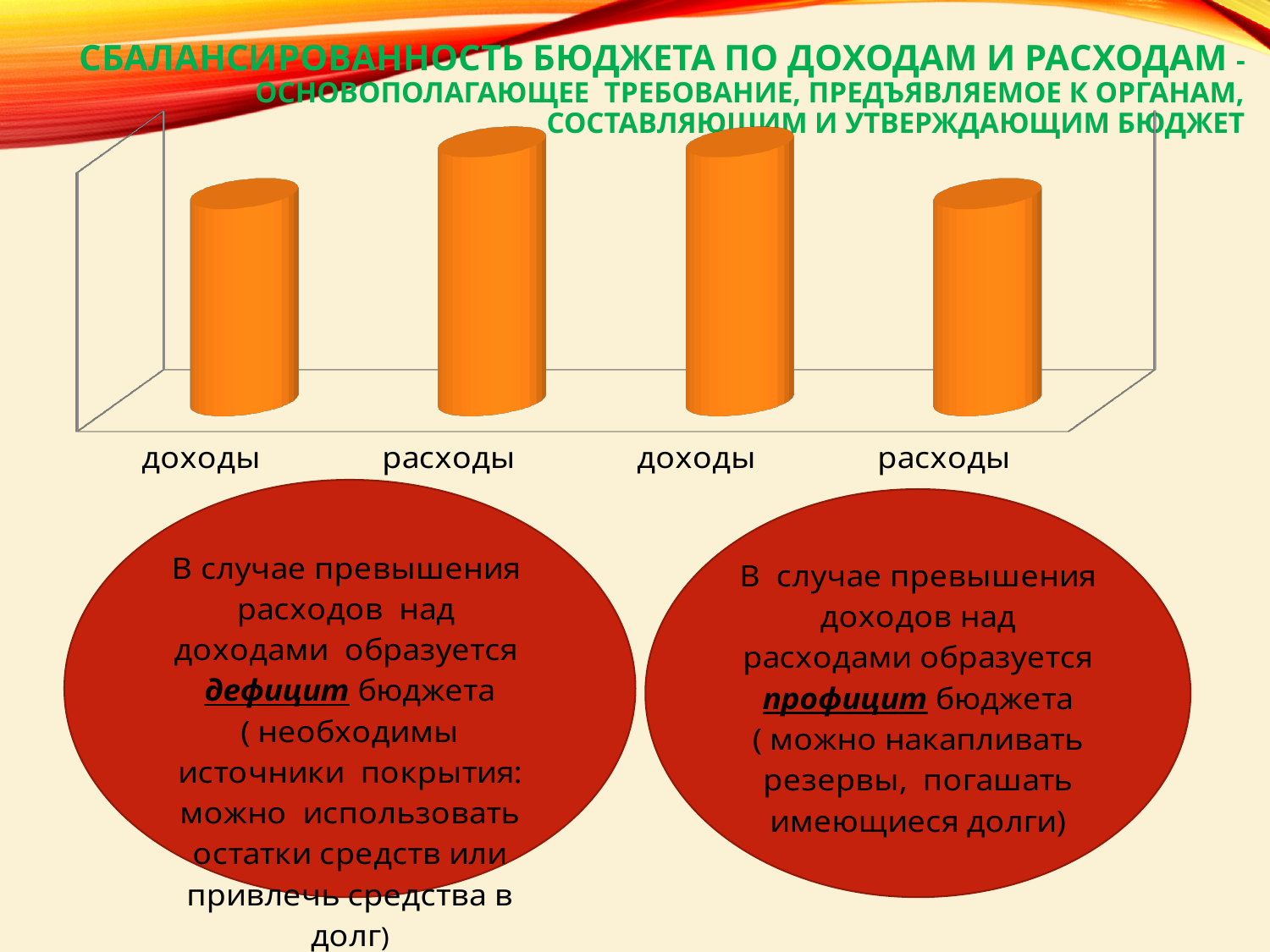
What colour are the bars in the chart? orange Which расходы bar is taller, the first (left) one or the second (right) one? the first (left) one What are the category labels shown under the bars, from left to right? доходы, расходы, доходы, расходы In the right pair of bars, which is taller: доходы or расходы? доходы How many bars does the chart contain? 4 What kind of chart is shown on the slide? bar chart In the left pair of bars, which is taller: доходы or расходы? расходы Does the chart display numeric data labels on the bars? no